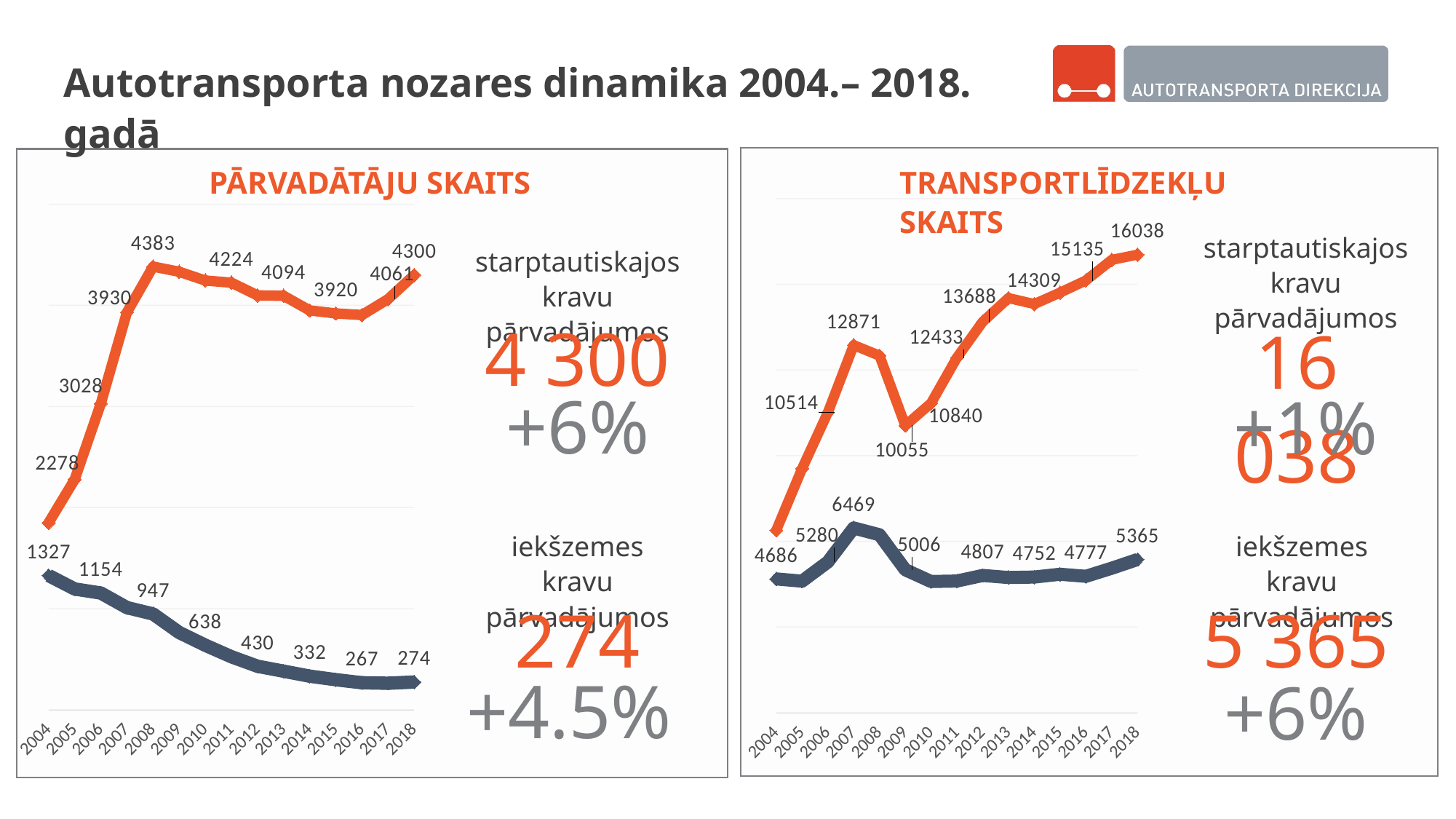
In the 'TRANSPORTLĪDZEKĻU SKAITS' chart, what is the value of the international freight line in 2018? 16038 In the 'PĀRVADĀTĀJU SKAITS' chart, what is the value of the domestic freight (iekšzemes kravu pārvadājumos) line in 2004? 1327 In the 'TRANSPORTLĪDZEKĻU SKAITS' chart, what percentage change is shown for domestic freight (iekšzemes kravu pārvadājumos)? +6% In the 'PĀRVADĀTĀJU SKAITS' chart, what is the value of the international freight (starptautiskajos kravu pārvadājumos) line in 2018? 4300 What type of chart is used in the 'PĀRVADĀTĀJU SKAITS' chart? line chart In the 'PĀRVADĀTĀJU SKAITS' chart, what is the difference between the international and domestic values in 2018? 4026 In the 'PĀRVADĀTĀJU SKAITS' chart, what is the highest value reached by the international freight line? 4383 In the 'TRANSPORTLĪDZEKĻU SKAITS' chart, which line has the larger value in 2018, international or domestic freight? international In the 'PĀRVADĀTĀJU SKAITS' chart, how many years are shown on the x axis? 15 In the 'PĀRVADĀTĀJU SKAITS' chart, does the domestic freight line generally rise or fall from 2004 to 2018? fall In the 'TRANSPORTLĪDZEKĻU SKAITS' chart, what is the highest value reached by the domestic freight line? 6469